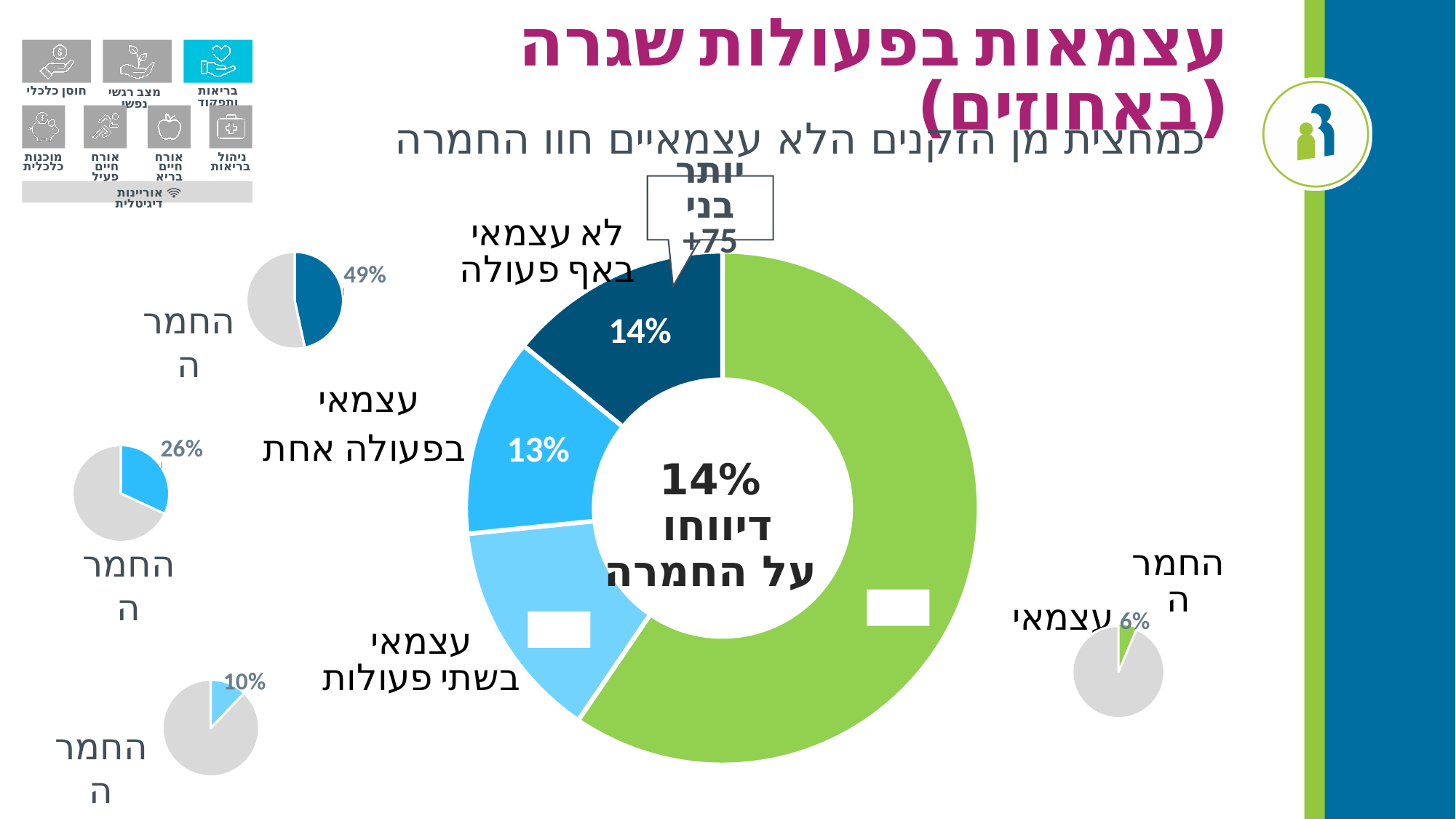
In the main donut chart, what percentage is shown for the slice labelled "לא עצמאי באף פעולה"? 14% Among the four small "החמרה" pies, which group has the lowest percentage? עצמאי (6%) In the main donut chart, what is the difference in percentage points between "לא עצמאי באף פעולה" (14%) and "עצמאי בפעולה אחת" (13%)? 1 percentage point In the main donut chart, which category has the largest slice? עצמאי What kind of chart is the large chart in the centre of the slide? Donut (pie) chart In the main donut chart, which slice is larger: "לא עצמאי באף פעולה" or "עצמאי בפעולה אחת"? לא עצמאי באף פעולה How many slices does the main donut chart have? 4 In the small "החמרה" pie next to "עצמאי בפעולה אחת", what percentage is shown? 26% What text is printed in the centre of the main donut chart? 14% דיווחו על החמרה In the main donut chart, what percentage is shown for the slice labelled "עצמאי בפעולה אחת"? 13% In the small "החמרה" pie next to "עצמאי" (the green group), what percentage is shown? 6% In the small "החמרה" pie next to "לא עצמאי באף פעולה", what percentage is shown? 49%